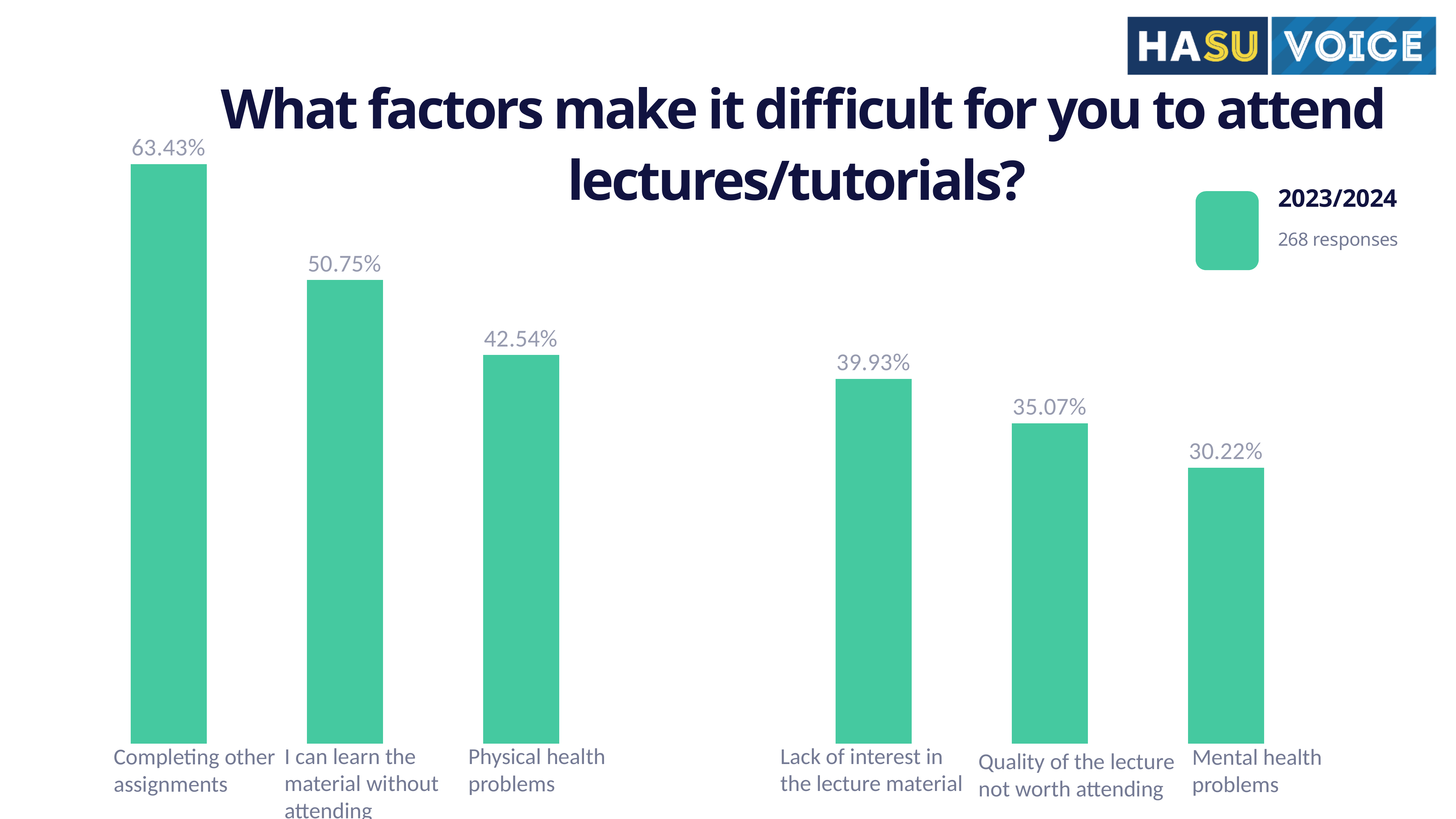
What is the value shown for "Mental health problems"? 30.22% How many responses does the legend say the 2023/2024 data is based on? 268 responses What is the value shown for "Lack of interest in the lecture material"? 39.93% Which factor has the lowest percentage in the chart? Mental health problems What is the value shown for "Quality of the lecture not worth attending"? 35.07% What type of chart is shown on the slide? Bar chart Which factor has the highest percentage in the chart? Completing other assignments What is the difference in percentage points between "Completing other assignments" and "I can learn the material without attending"? 12.68 Which is larger: the value for "Physical health problems" or the value for "Quality of the lecture not worth attending"? Physical health problems What percentage of respondents cited "Completing other assignments" as a factor making it difficult to attend lectures/tutorials? 63.43% What is the difference in percentage points between "Physical health problems" and "Lack of interest in the lecture material"? 2.61 How many factors (bars) are shown in the chart? 6